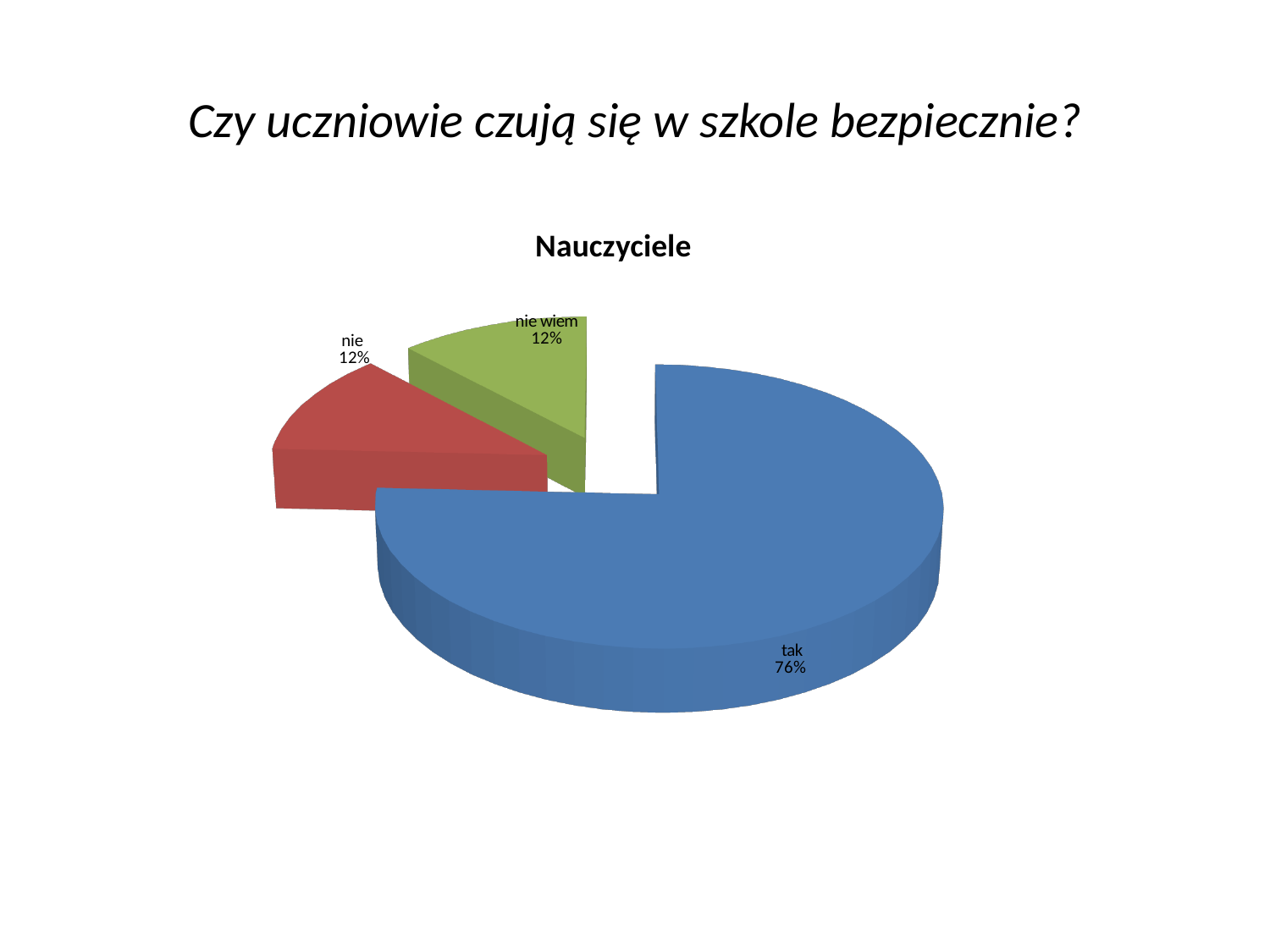
What percentage of the pie is the 'tak' slice? 76% What percentage of the pie is the 'nie' slice? 12% What is the difference between the 'tak' share and the 'nie' share? 64% What colour is the 'tak' slice? blue What is the combined share of the 'nie' and 'nie wiem' slices? 24% What type of chart is shown on the slide? pie chart How many slices does the pie chart have? 3 Which is larger, the 'tak' slice or the 'nie wiem' slice? tak Which slice is the largest? tak What is the chart's title? Nauczyciele What percentage of the pie is the 'nie wiem' slice? 12%